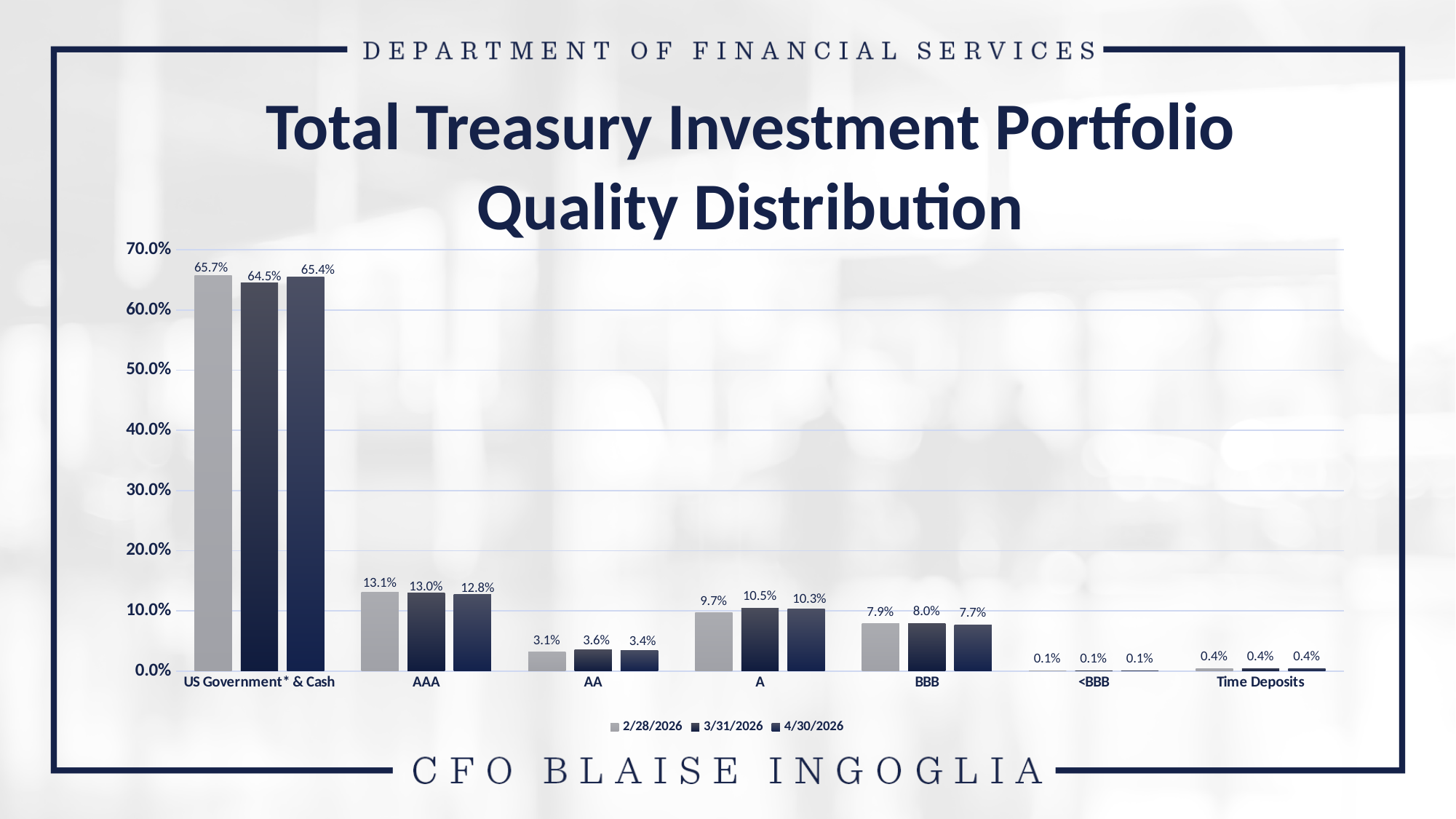
What is the difference between the 2/28/2026 and 3/31/2026 values for US Government* & Cash? 1.2% Is the value for AAA in the 2/28/2026 series greater or less than 10.0%? greater What kind of chart is shown on the slide? Bar chart Which category has the highest value in the 4/30/2026 series? US Government* & Cash What is the value for US Government* & Cash in the 2/28/2026 series? 65.7% What is the value for AAA in the 4/30/2026 series? 12.8% How many categories are shown on the x axis? 7 How many series does the legend list? 3 What is the title of the chart? Total Treasury Investment Portfolio Quality Distribution Which category has the lowest value in the 2/28/2026 series? <BBB Which is larger for BBB: the 3/31/2026 value or the 4/30/2026 value? 3/31/2026 What is the value for A in the 3/31/2026 series? 10.5%